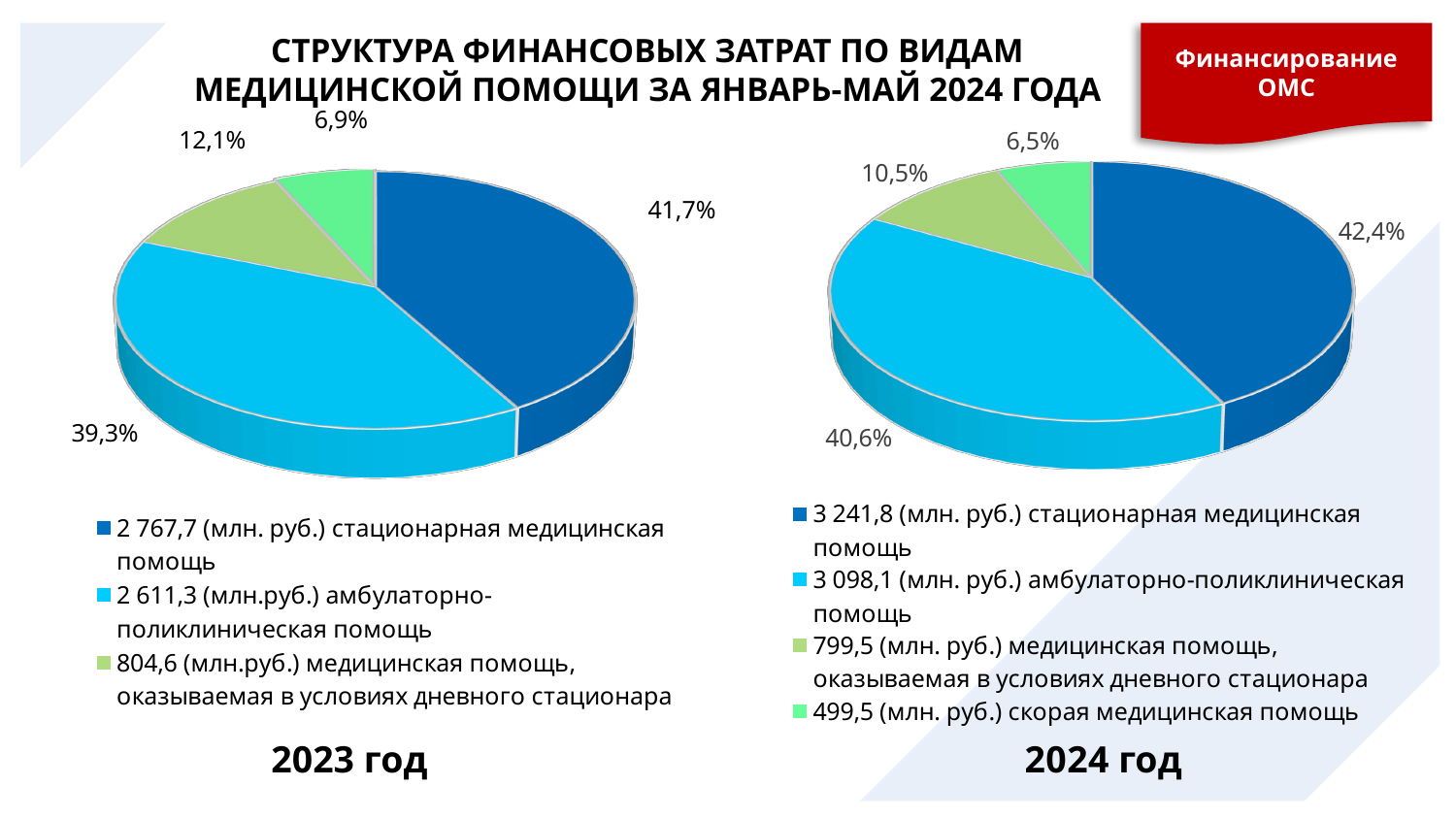
In the 2024 год pie chart, which category has the largest share? стационарная медицинская помощь What kind of chart is used for the 2023 год data on the left? pie chart In the 2024 год pie chart, which category has the smallest share? скорая медицинская помощь In the 2023 год pie chart, which is larger: the share for стационарная медицинская помощь or the share for амбулаторно-поликлиническая помощь? стационарная медицинская помощь In the 2024 год pie chart, what is the difference in percentage points between стационарная медицинская помощь and амбулаторно-поликлиническая помощь? 1,8 According to the legend of the 2024 год pie chart, what amount in млн. руб. is given for амбулаторно-поликлиническая помощь? 3 098,1 In the 2024 год pie chart, what percentage share is shown for стационарная медицинская помощь? 42,4% In the 2023 год pie chart, what percentage share is shown for стационарная медицинская помощь? 41,7% How many slices does the 2024 год pie chart have? 4 In the 2023 год pie chart, what percentage share is shown for медицинская помощь, оказываемая в условиях дневного стационара? 12,1% In the 2024 год pie chart, what percentage share is shown for скорая медицинская помощь? 6,5% In the 2023 год pie chart, what percentage share is shown for амбулаторно-поликлиническая помощь? 39,3%